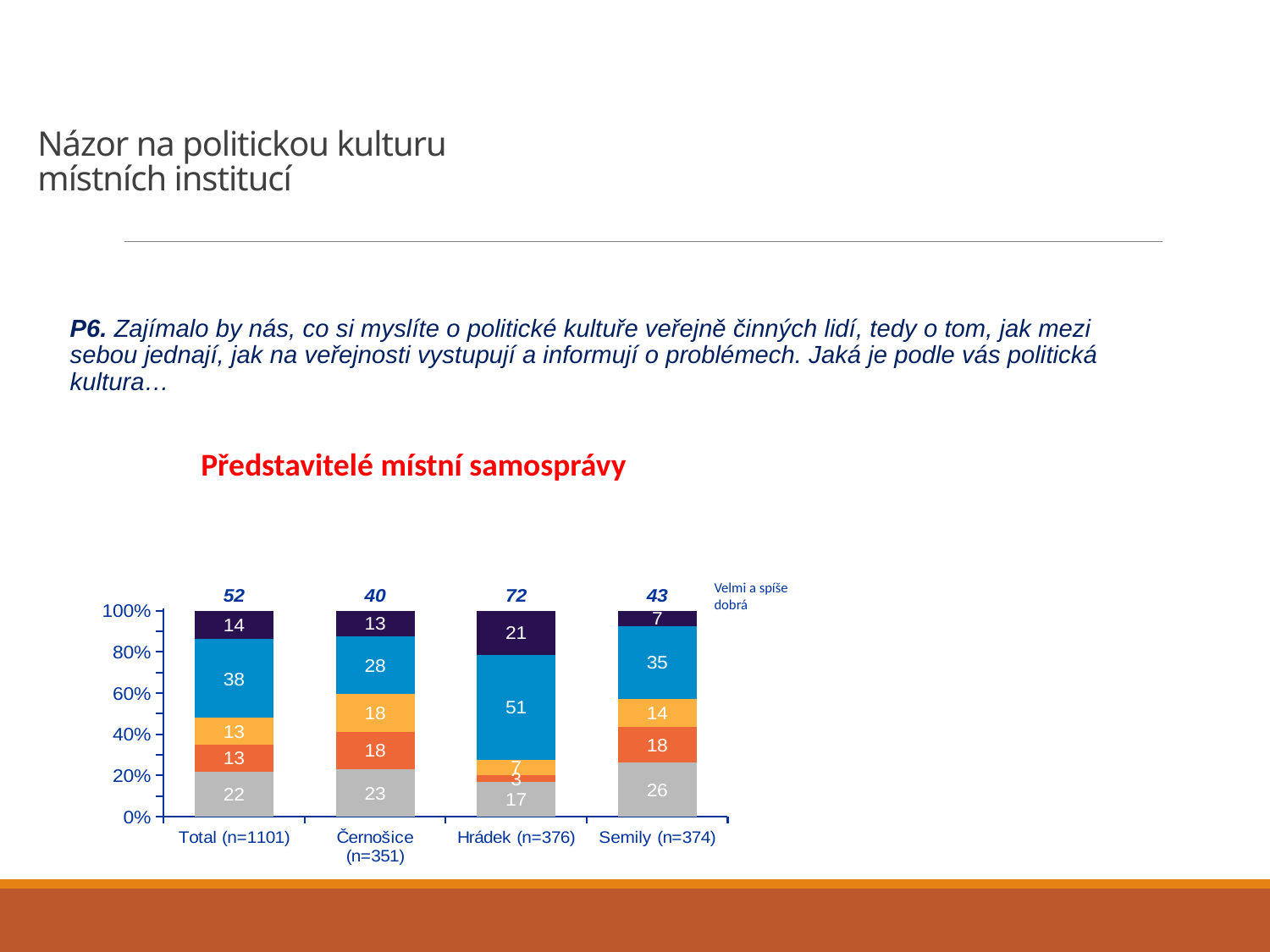
What is the difference between the 'Velmi a spíše dobrá' values for Hrádek (n=376) and Černošice (n=351)? 32 How many categories are shown on the x axis of the chart? 4 What kind of chart is shown on the slide? Stacked bar chart What is the title shown in red above the chart? Představitelé místní samosprávy Which category has the smallest dark navy top segment? Semily (n=374) What is the value of the orange segment for Černošice (n=351)? 18 What is the difference between the grey segment values for Semily (n=374) and Hrádek (n=376)? 9 What is the value of the light blue segment for Hrádek (n=376)? 51 Which category has the highest 'Velmi a spíše dobrá' value shown above the bars? Hrádek (n=376) What is the 'Velmi a spíše dobrá' value shown above the bar for Total (n=1101)? 52 Which is larger: the light blue segment for Total (n=1101) or for Semily (n=374)? Total (n=1101) What is the value of the grey bottom segment for Semily (n=374)? 26